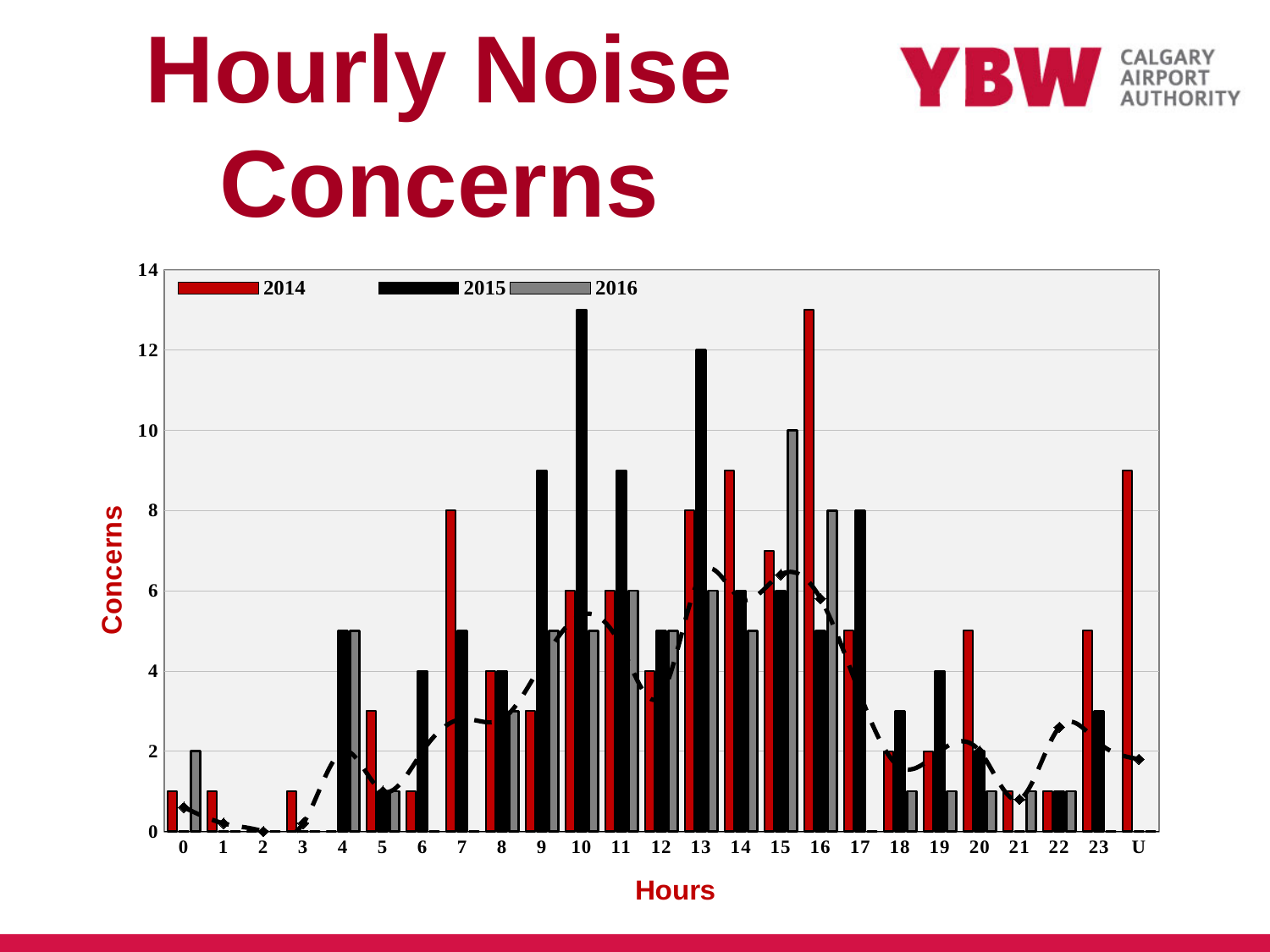
How many hour categories are shown along the x axis? 25 At hour 13, which is larger, the 2014 value or the 2015 value? 2015 What is the 2014 value at hour 7? 8 At which hour is the 2016 bar highest? 15 What is the 2016 value at hour 15? 10 What kind of chart is shown on the slide? Combination bar and line chart Is the 2014 value at hour U greater or less than 8? greater What is the title of the y axis? Concerns What is the 2015 value at hour 13? 12 Is the 2015 value at hour 10 greater or less than 12? greater What is the difference between the 2016 value at hour 15 and the 2016 value at hour 0? 8 How many series does the legend list? 3